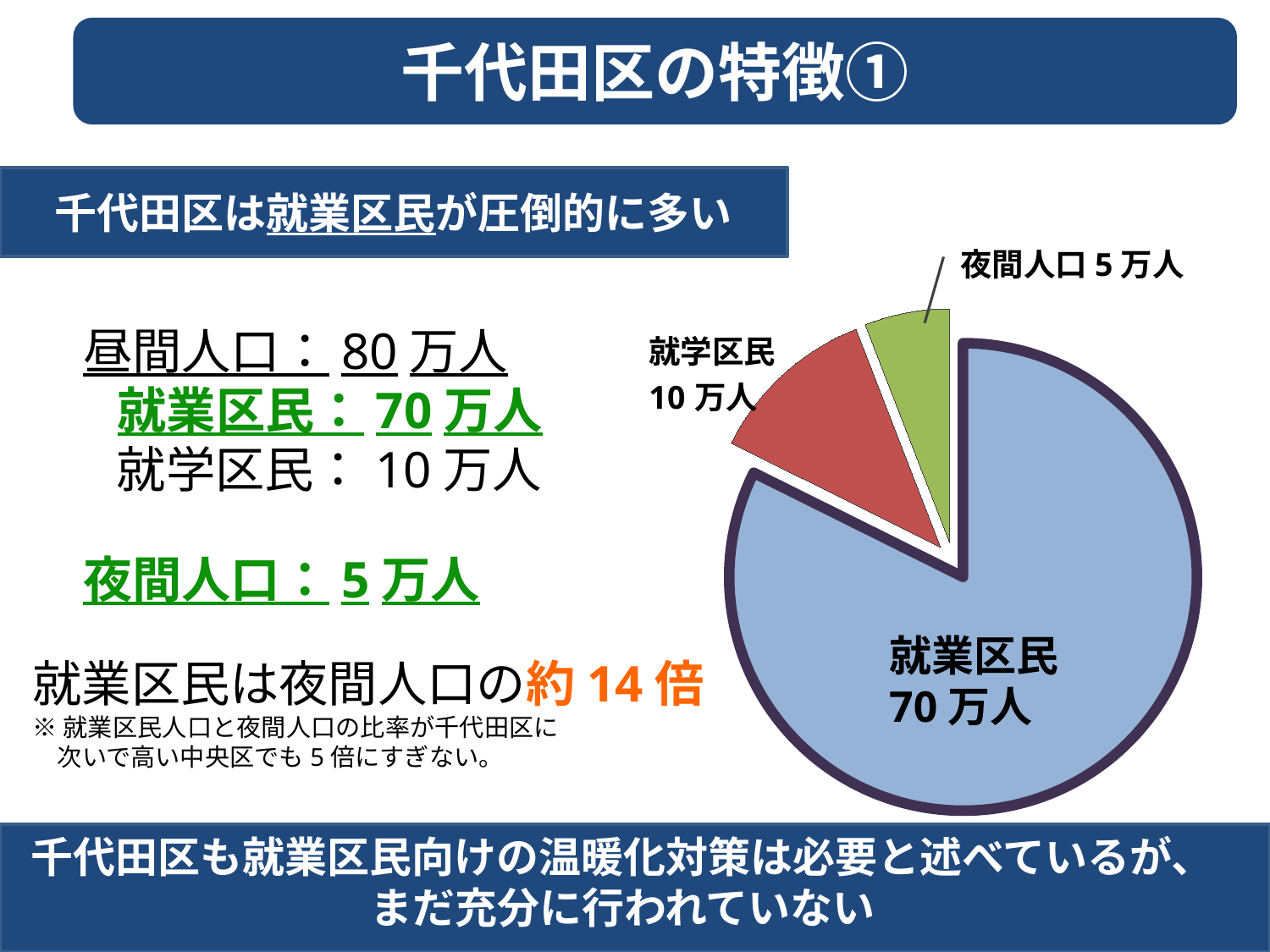
Which is larger in the pie chart, 就学区民 or 夜間人口? 就学区民 What colour is the 就業区民 slice in the pie chart? Light blue What is the difference between the 就学区民 value and the 夜間人口 value in the pie chart? 5 万人 What is the value shown for 就学区民 in the pie chart? 10 万人 Which slice of the pie chart is the largest? 就業区民 What is the value shown for 就業区民 in the pie chart? 70 万人 How many slices does the pie chart have? 3 What is the total of all three slices in the pie chart? 85 万人 What kind of chart is shown on the slide? Pie chart Which slice of the pie chart is the smallest? 夜間人口 What is the value shown for 夜間人口 in the pie chart? 5 万人 What is the difference between the 就業区民 value and the 就学区民 value in the pie chart? 60 万人